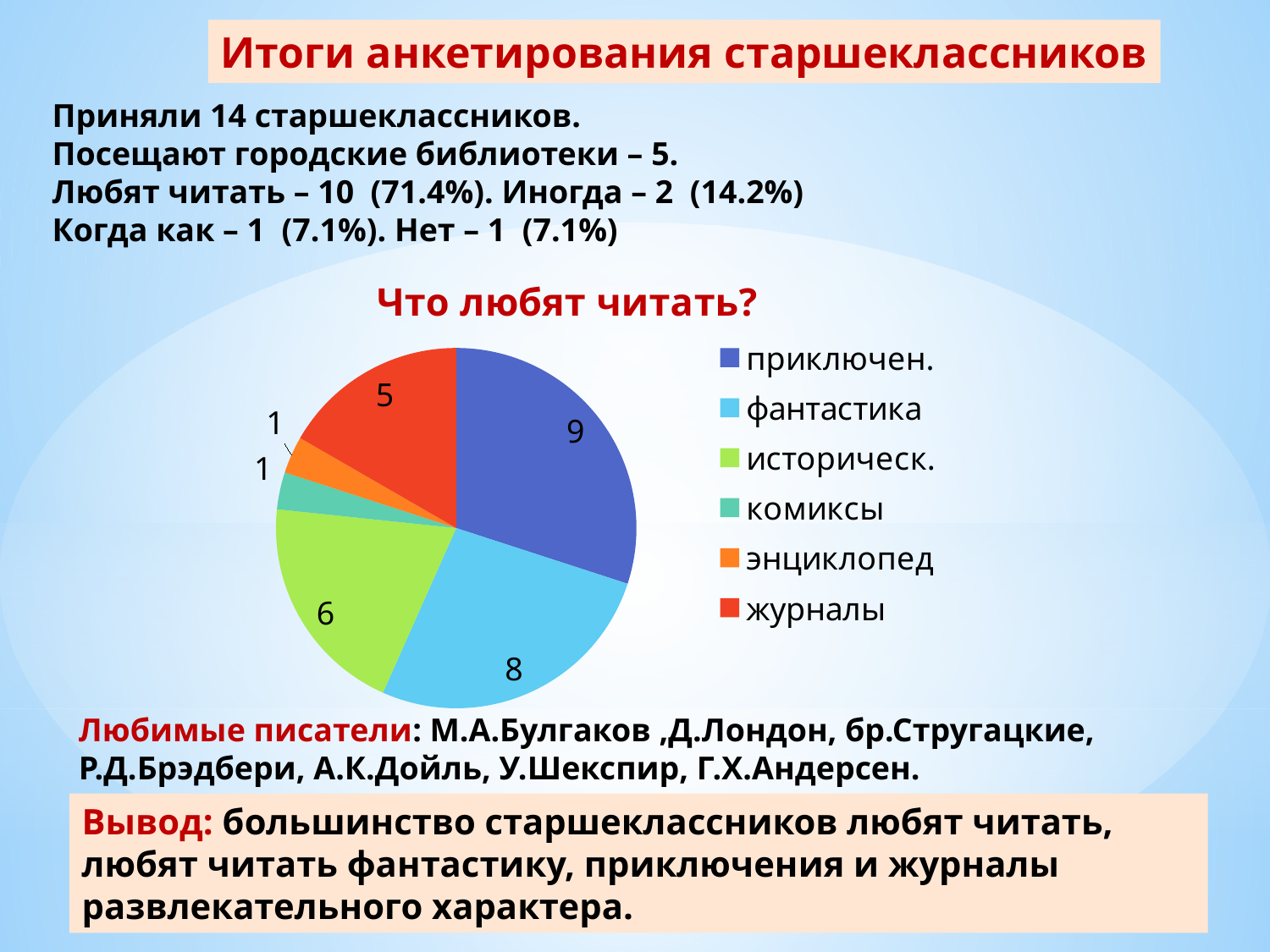
What is the title of the pie chart? Что любят читать? Which is larger in the pie chart, приключен. or фантастика? приключен. What is the value for журналы in the pie chart? 5 What is the difference between the values for приключен. and журналы in the pie chart? 4 What is the value for историческ. in the pie chart? 6 How many categories does the pie chart show? 6 What is the value for комиксы in the pie chart? 1 What is the value for фантастика in the pie chart? 8 What kind of chart is shown under the title "Что любят читать?"? pie chart Which category has the largest slice in the pie chart? приключен. What is the value for приключен. in the pie chart? 9 What share of the pie does приключен. represent? 30%